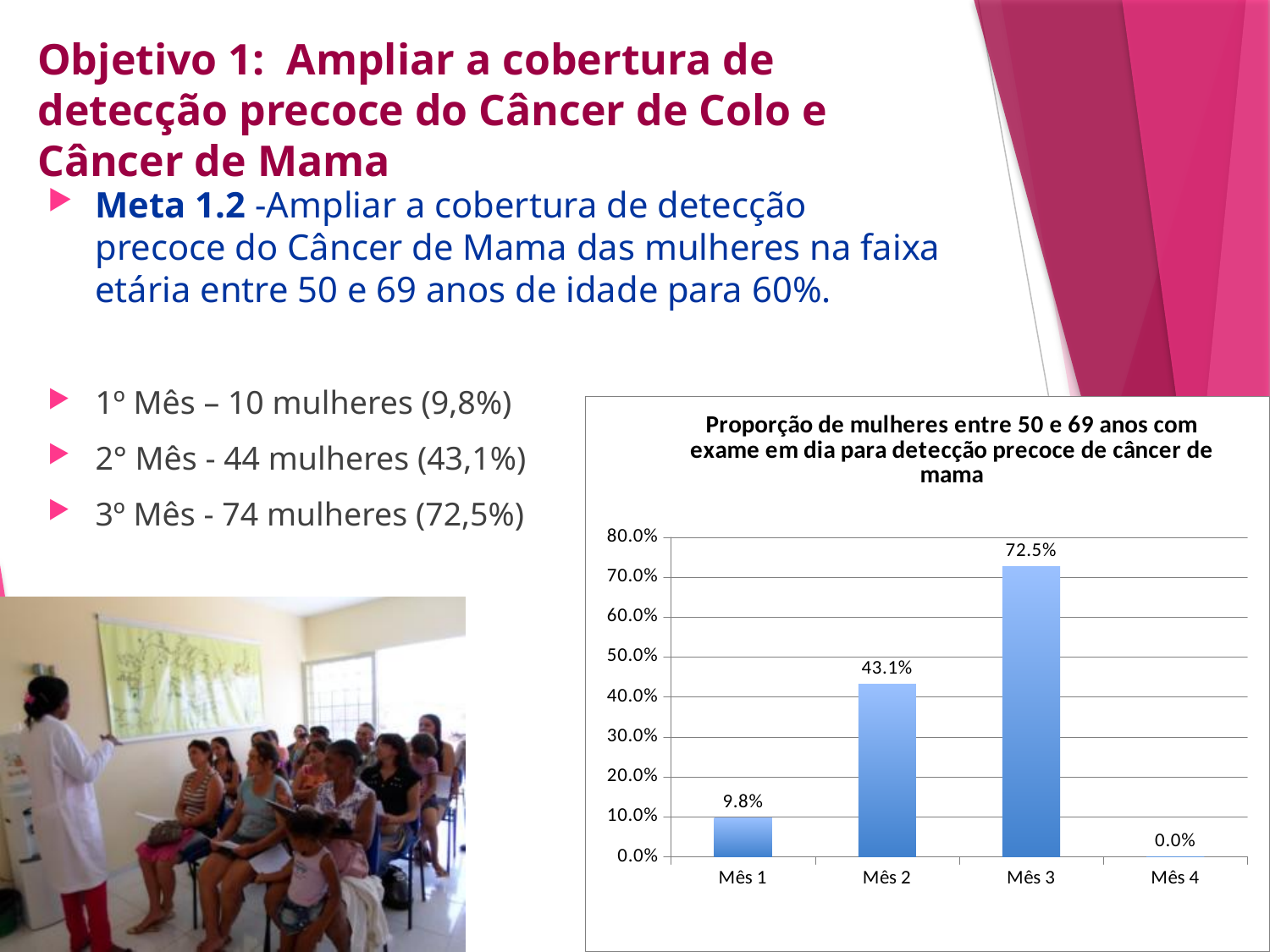
What is the value for Mês 1? 9.8% What is the title of the chart? Proporção de mulheres entre 50 e 69 anos com exame em dia para detecção precoce de câncer de mama What is the value for Mês 4? 0.0% How many categories are shown on the x axis? 4 What is the value for Mês 2? 43.1% What kind of chart is shown? bar chart Is the value for Mês 2 greater or less than 40.0%? greater Which is larger, the value for Mês 2 or the value for Mês 1? Mês 2 Which month has the highest value? Mês 3 What is the difference between the values for Mês 3 and Mês 2? 29.4% Which month has the lowest value? Mês 4 What is the value for Mês 3? 72.5%